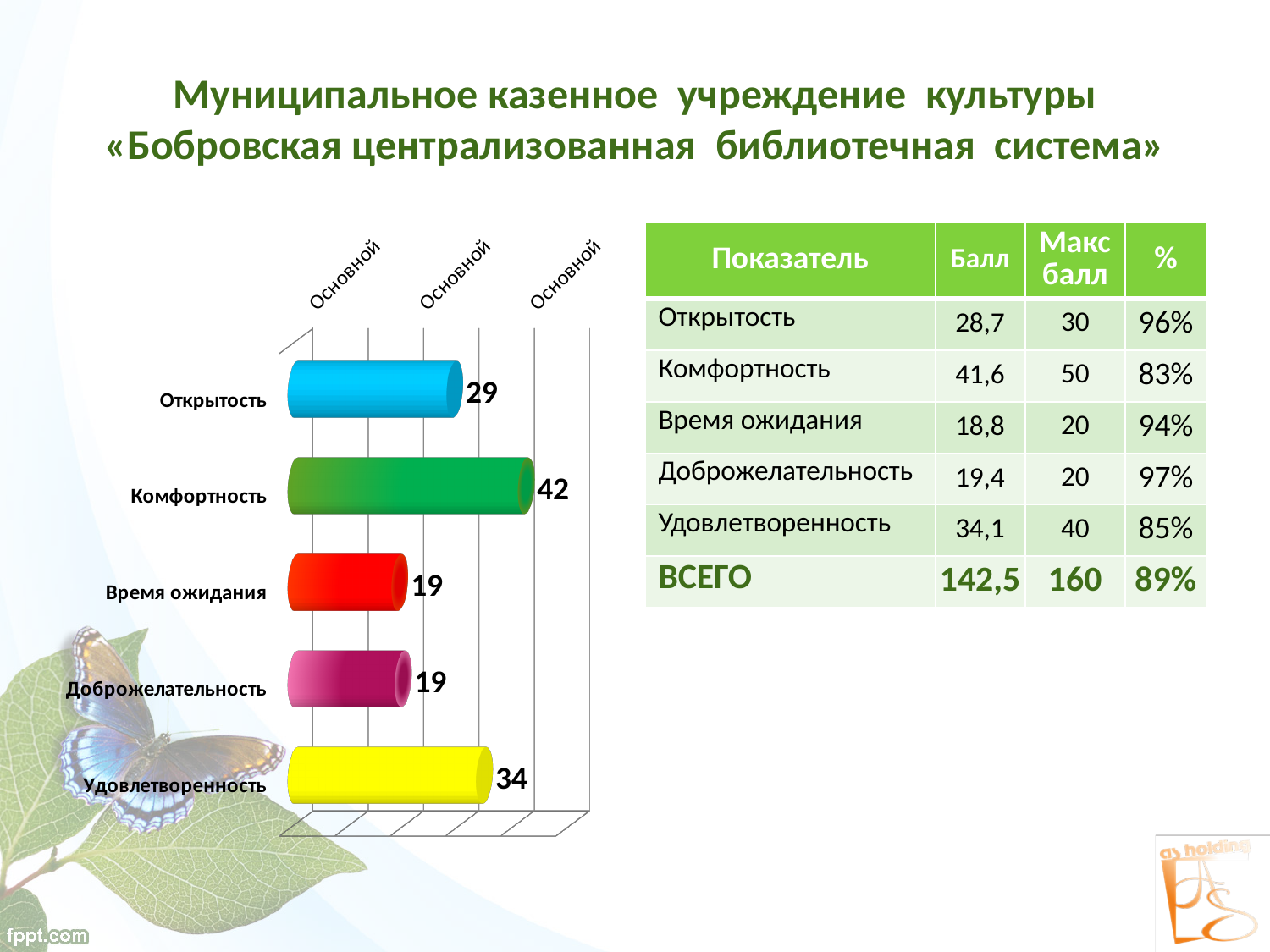
What value does the chart show for Комфортность? 42 What colour is the bar for Время ожидания in the chart? Red What value does the chart show for Удовлетворенность? 34 Which is larger in the chart, the value for Удовлетворенность or the value for Открытость? Удовлетворенность What value does the chart show for Время ожидания? 19 Which category has the highest value in the chart? Комфортность What kind of chart is shown on the slide? Bar chart What is the difference between the values for Удовлетворенность and Доброжелательность in the chart? 15 How many categories are shown in the chart? 5 What value does the chart show for Открытость? 29 What is the difference between the values for Комфортность and Открытость in the chart? 13 Which is larger in the chart, the value for Комфортность or the value for Удовлетворенность? Комфортность